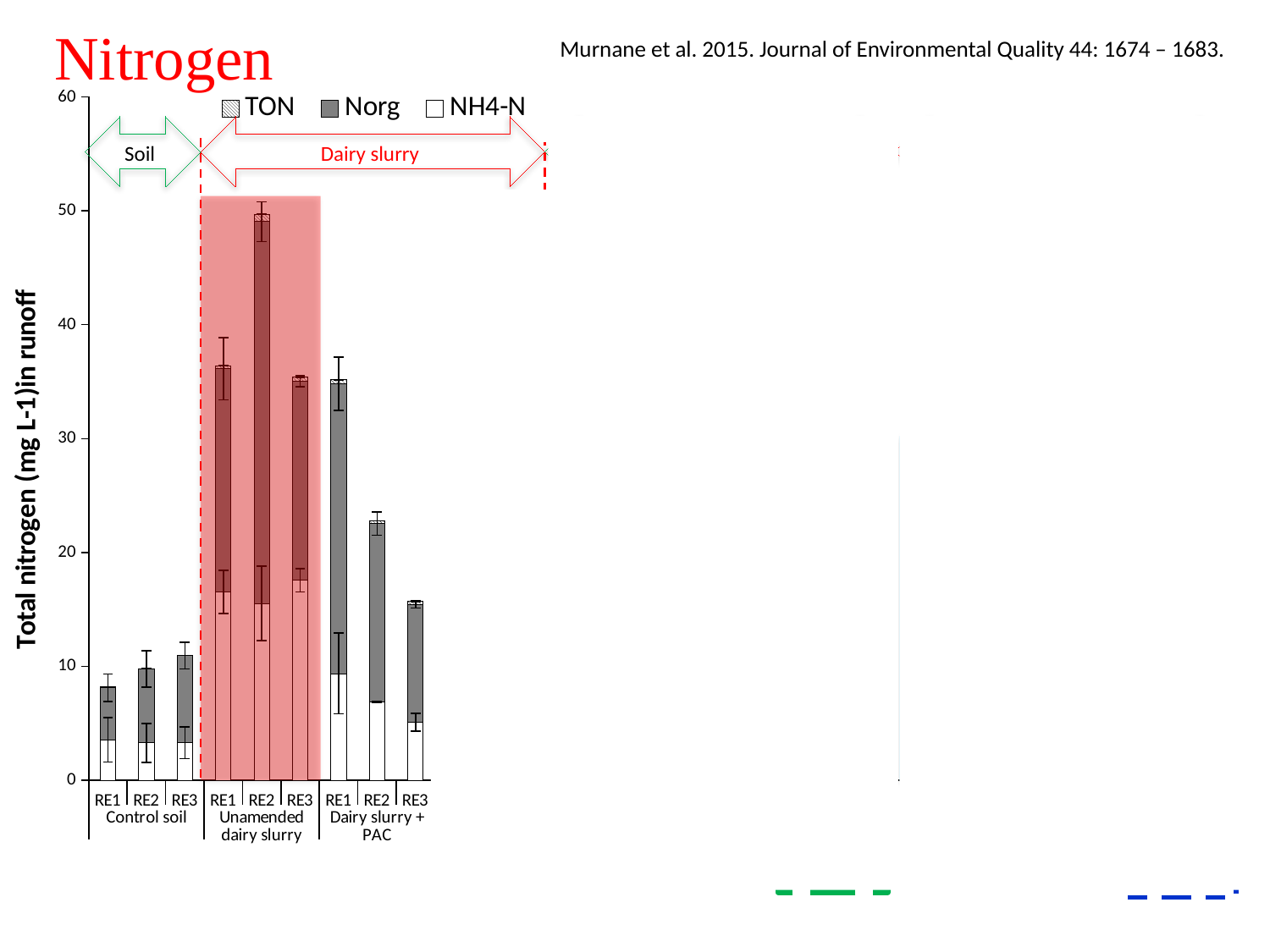
Which is larger, the total for Unamended dairy slurry RE2 or Dairy slurry + PAC RE2? Unamended dairy slurry RE2 Is the total for Dairy slurry + PAC RE3 greater or less than 20? less Is the total for Control soil RE3 greater or less than 20? less How many bars are plotted in the chart? 9 Which bar has the highest total nitrogen? Unamended dairy slurry RE2 Is the total for Unamended dairy slurry RE1 greater or less than 30? greater What kind of chart is shown on the slide? Stacked bar chart What is the y-axis title of the chart? Total nitrogen (mg L-1)in runoff Which series are listed in the legend? TON, Norg, NH4-N Which bar has the lowest total nitrogen? Control soil RE1 How many series does the legend list? 3